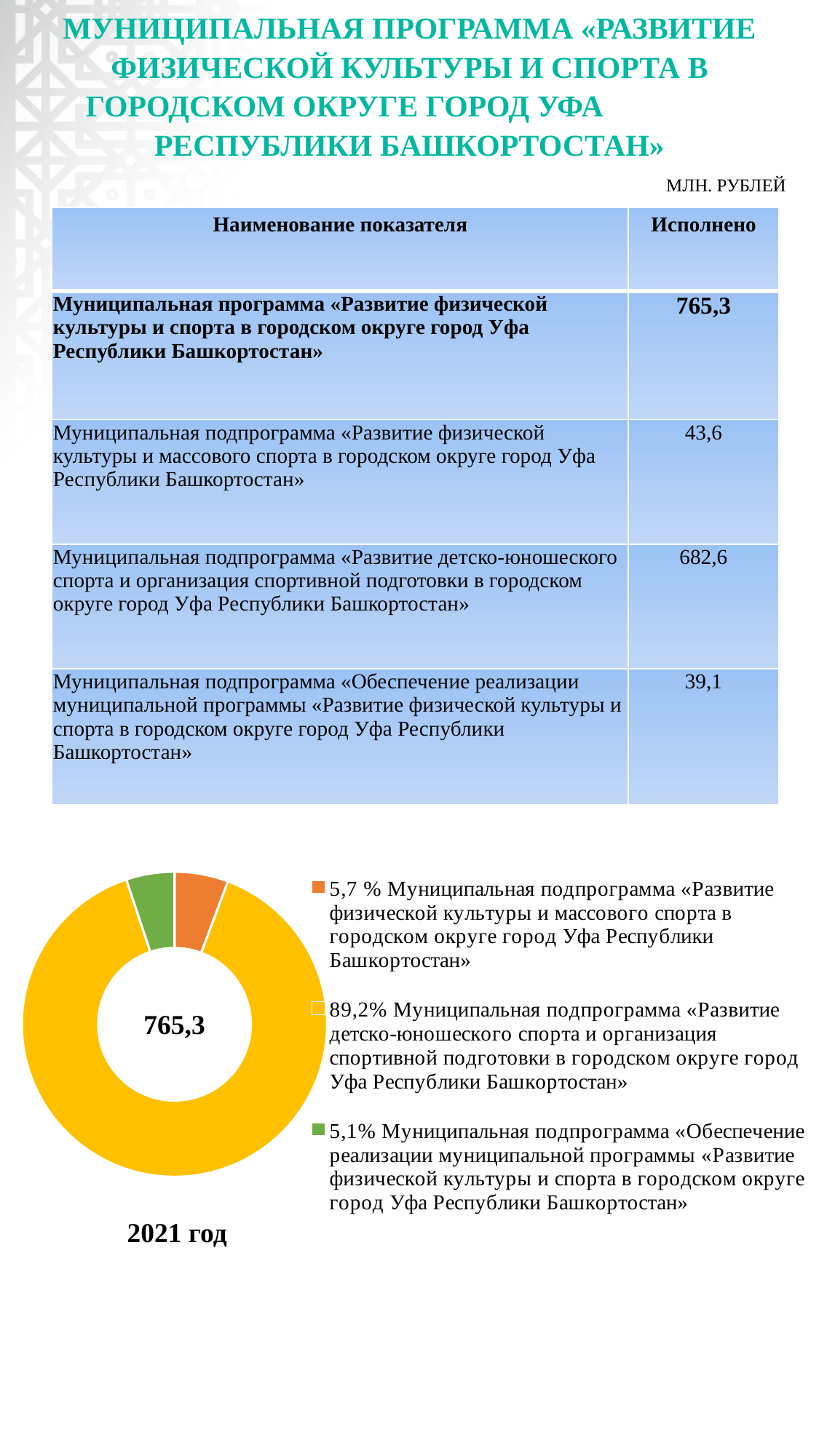
What kind of chart is shown at the bottom of the slide? Doughnut (pie) chart What share of the doughnut chart does the subprogram «Развитие физической культуры и массового спорта в городском округе город Уфа Республики Башкортостан» take? 5,7 % Which subprogram has the largest slice in the doughnut chart? «Развитие детско-юношеского спорта и организация спортивной подготовки в городском округе город Уфа Республики Башкортостан» Which subprogram has the smallest slice in the doughnut chart? «Обеспечение реализации муниципальной программы «Развитие физической культуры и спорта в городском округе город Уфа Республики Башкортостан» What share of the doughnut chart does the subprogram «Обеспечение реализации муниципальной программы «Развитие физической культуры и спорта в городском округе город Уфа Республики Башкортостан» take? 5,1% What value is printed in the centre of the doughnut chart? 765,3 What is the difference in percentage points between the 89,2% slice and the 5,7 % slice of the doughnut chart? 83,5 Which year is labelled under the doughnut chart? 2021 год How many slices does the doughnut chart have? 3 What share of the doughnut chart does the subprogram «Развитие детско-юношеского спорта и организация спортивной подготовки в городском округе город Уфа Республики Башкортостан» take? 89,2% What colour is the largest slice of the doughnut chart? Yellow How many entries does the legend of the doughnut chart list? 3